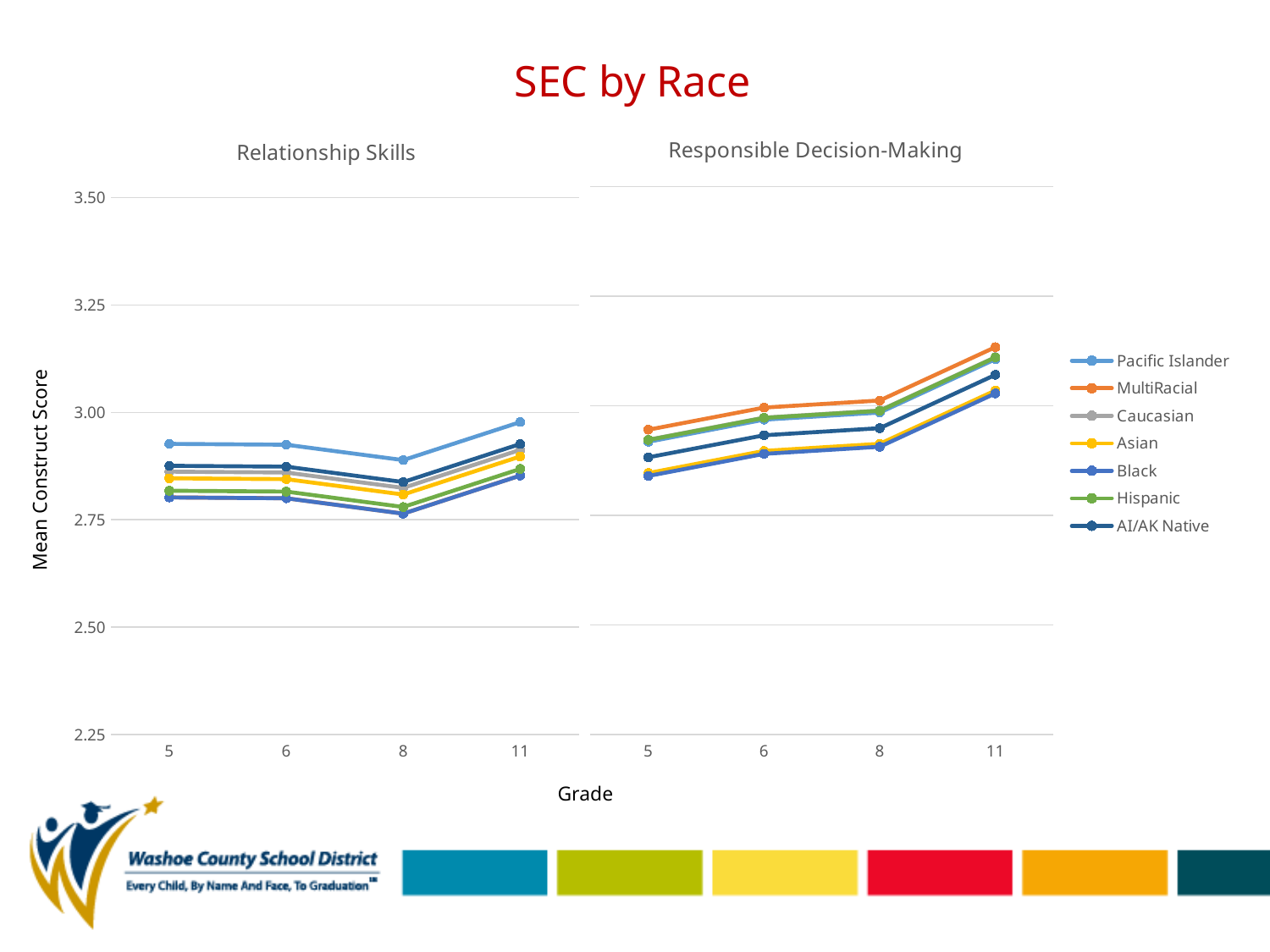
What is the label on the vertical axis? Mean Construct Score In the Relationship Skills chart, is the value for Pacific Islander at grade 5 greater or less than 2.75? greater In the Responsible Decision-Making chart, which is larger at grade 11: MultiRacial or Black? MultiRacial How many series does the legend list? 7 In the Responsible Decision-Making chart, which series has the highest value at grade 11? MultiRacial In the Responsible Decision-Making chart, is the value for MultiRacial at grade 11 greater or less than 3.00? greater In the Responsible Decision-Making chart, is the value for Black at grade 5 greater or less than 3.00? less In the Relationship Skills chart, does the Pacific Islander line rise or fall from grade 6 to grade 8? fall In the Responsible Decision-Making chart, does the MultiRacial line rise or fall from grade 5 to grade 11? rise What kind of chart is the Relationship Skills chart? line chart How many grade levels are plotted along the x axis of the Responsible Decision-Making chart? 4 In the Relationship Skills chart, which series has the highest value at grade 11? Pacific Islander